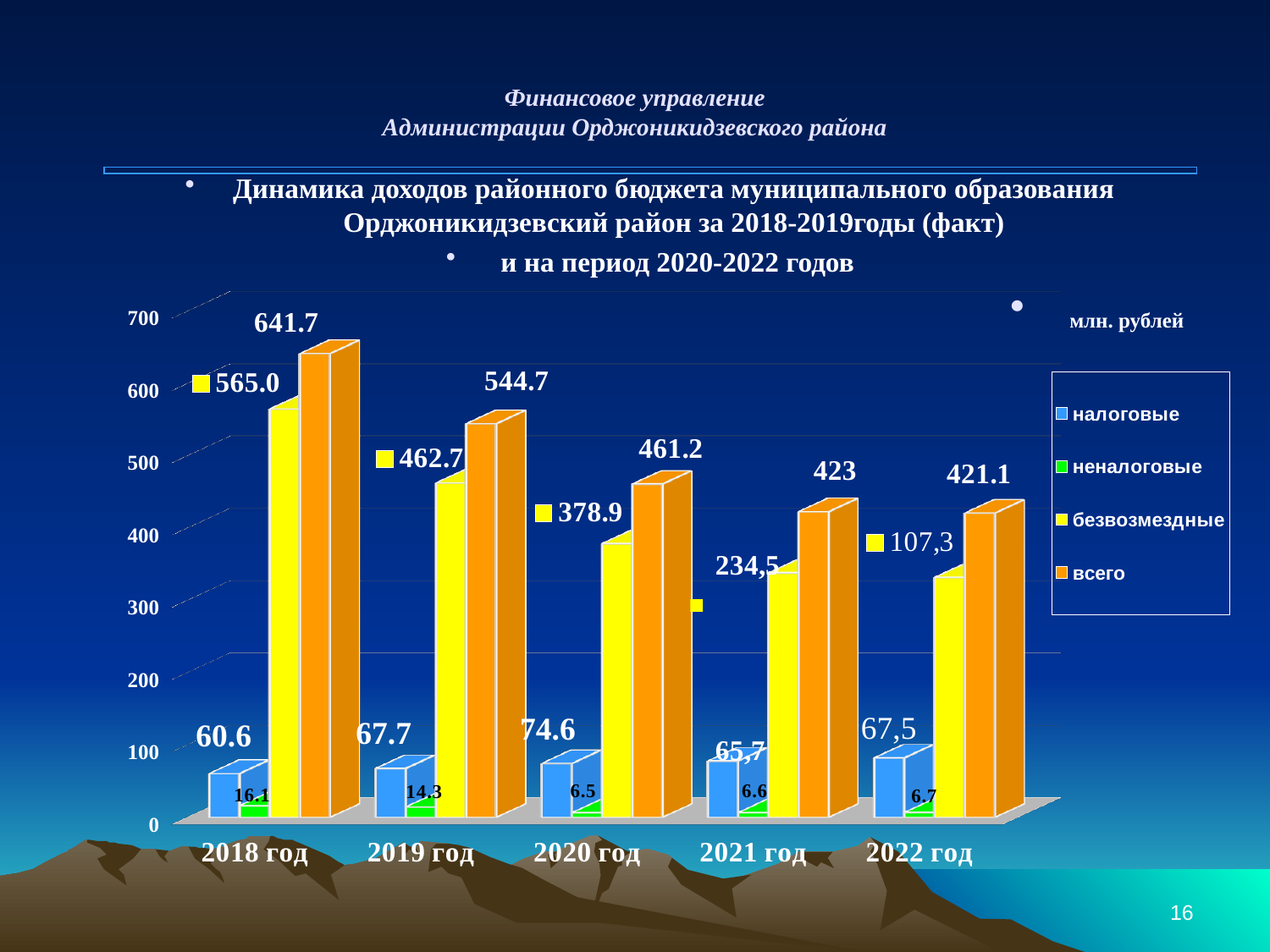
What is the difference between the всего values for 2018 год and 2019 год? 97.0 In which year is the всего value highest? 2018 год What is the value of неналоговые for 2019 год? 14.3 What is the value of безвозмездные for 2019 год? 462.7 How many series does the legend list? 4 Does the всего value rise or fall from 2018 год to 2022 год? fall Is the value of безвозмездные for 2018 год greater or less than 500? greater What is the value of налоговые for 2020 год? 74.6 What is the value of всего for 2018 год? 641.7 Which year has the larger всего value, 2021 год or 2022 год? 2021 год How many years are shown on the x axis? 5